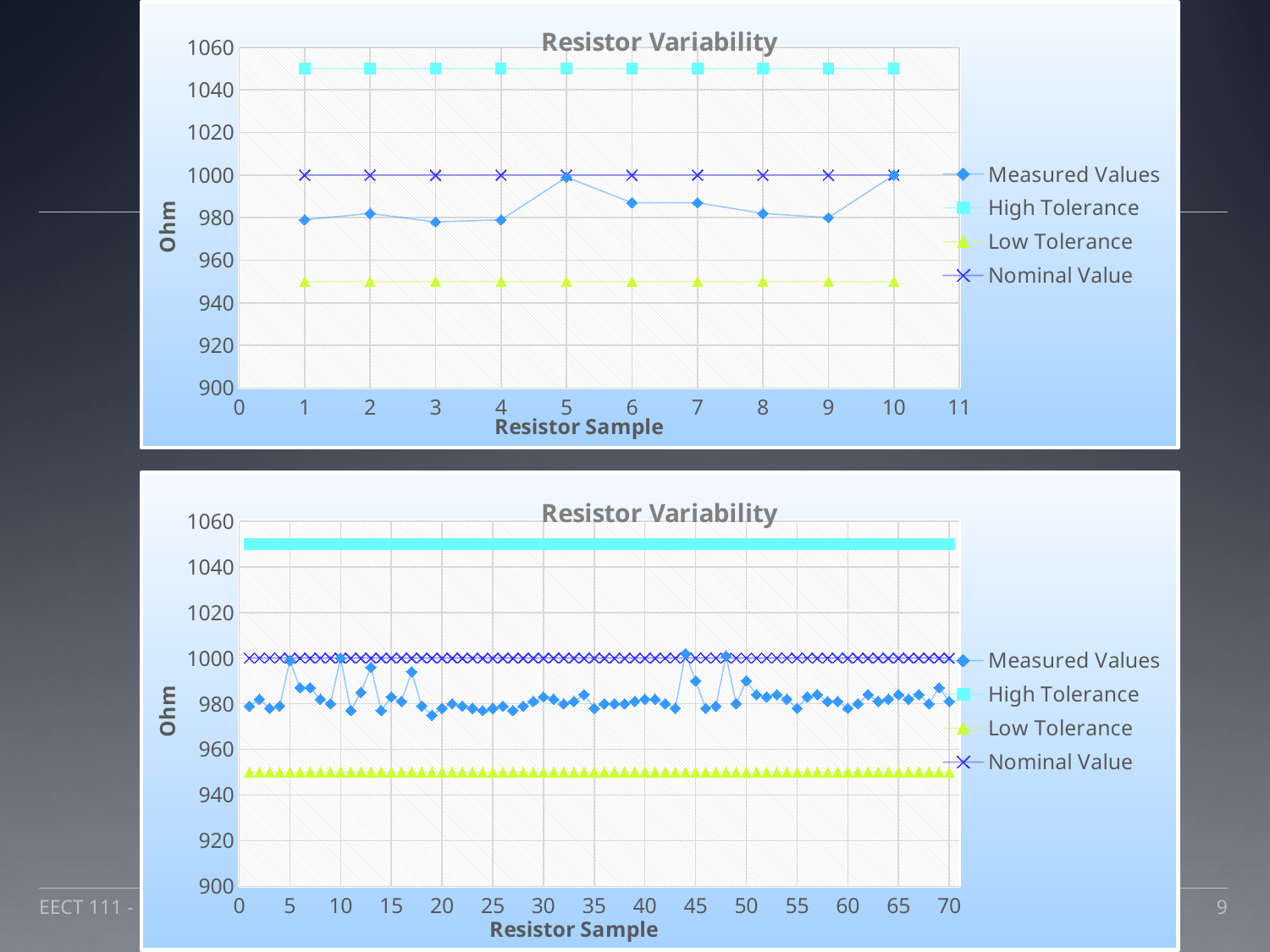
In the top chart, what type of chart is shown? line chart In the bottom chart, what is the Nominal Value at resistor sample 30? 1000 In the top chart, how many series does the legend list? 4 In the top chart, is the Measured Value at resistor sample 7 greater or less than 1000? less In the top chart, how many Measured Values data points are plotted? 10 What is the label on the y axis of the bottom chart? Ohm In the top chart, what is the Nominal Value at resistor sample 5? 1000 In the bottom chart, is the Measured Value at resistor sample 45 greater or less than 1000? less In the top chart, is the Measured Value at resistor sample 7 greater or less than 980? greater In the bottom chart, which is larger, High Tolerance or Low Tolerance? High Tolerance In the top chart, which series has the lowest values? Low Tolerance In the top chart, which series has the highest values? High Tolerance